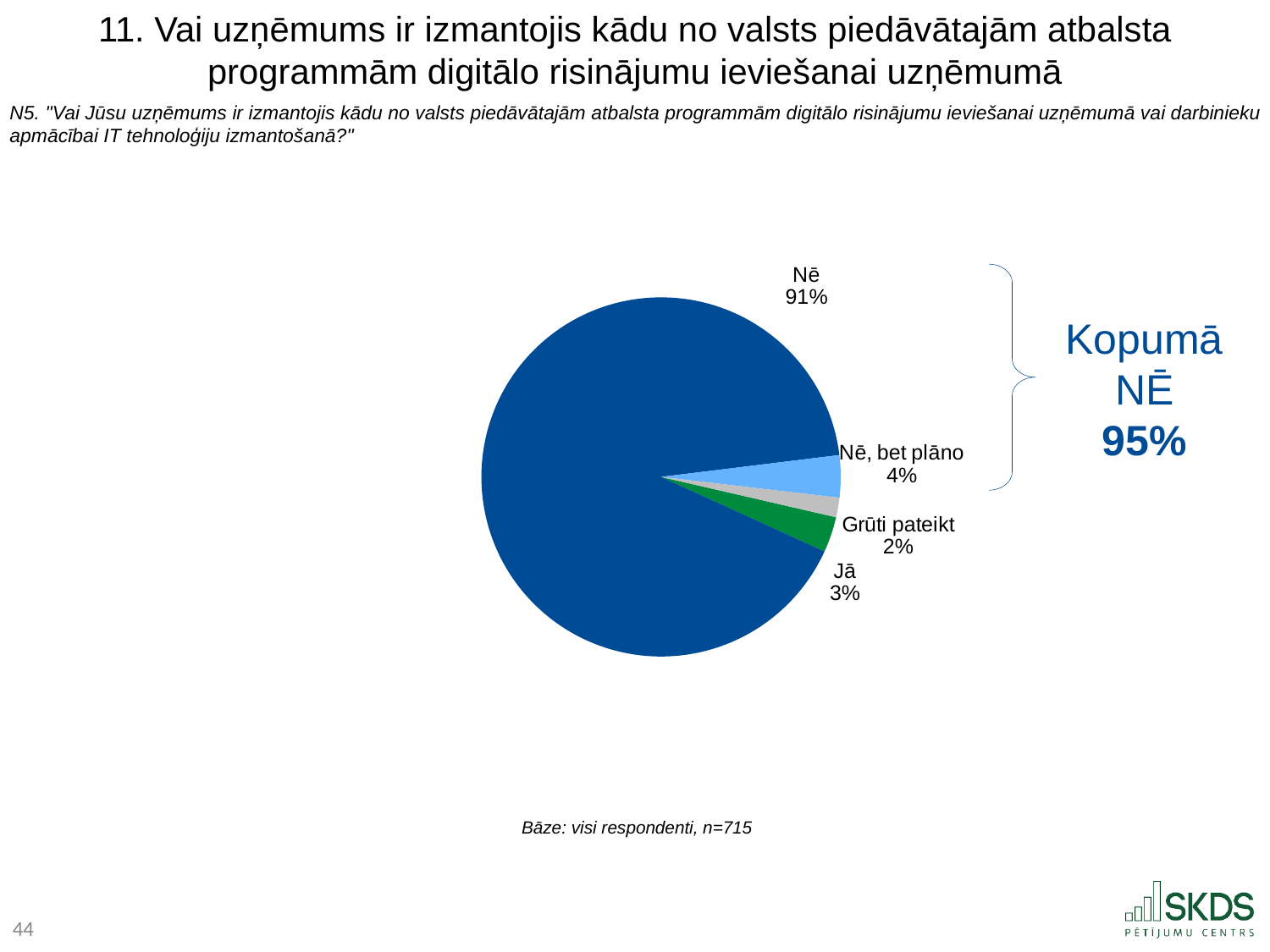
Which answer category has the largest slice of the pie? Nē What kind of chart is shown on the slide? pie chart What share of respondents answered "Nē, bet plāno"? 4% What share of respondents answered "Grūti pateikt"? 2% What combined percentage is shown for "Kopumā NĒ" next to the pie chart? 95% Which answer category has the smallest slice of the pie? Grūti pateikt How many slices does the pie chart have? 4 Which is larger, the share for "Nē, bet plāno" or the share for "Jā"? Nē, bet plāno What is the base (number of respondents) stated below the chart? n=715 What is the difference in percentage points between "Nē" and "Jā"? 88 What share of respondents answered "Nē"? 91% What share of respondents answered "Jā"? 3%